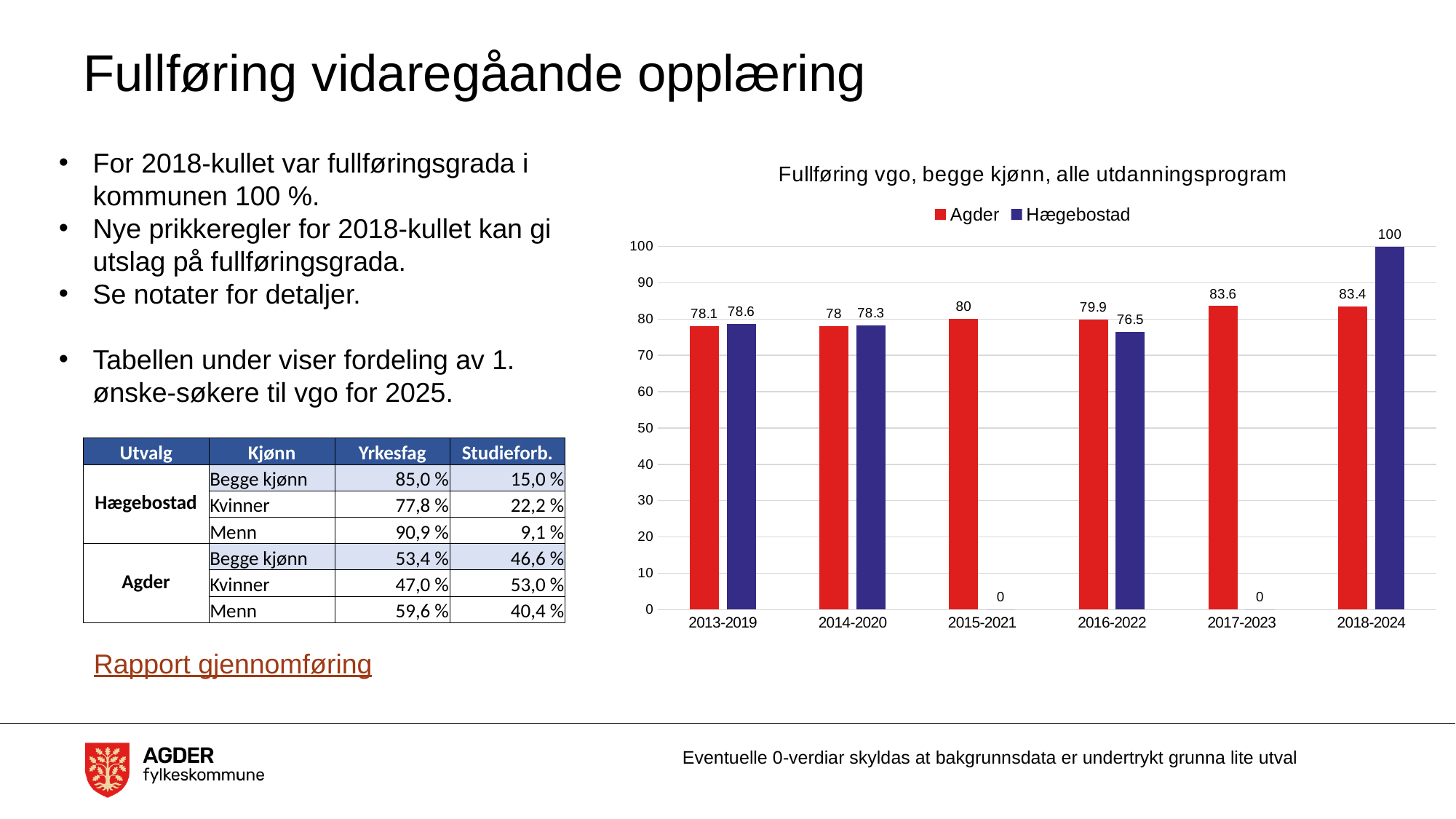
What is the difference between the Agder and Hægebostad values in 2016-2022? 3.4 In which period is the Agder value highest? 2017-2023 How many periods are shown on the x axis? 6 What kind of chart is shown? Bar chart What is the value for Hægebostad in 2016-2022? 76.5 Which is larger in 2014-2020, Agder or Hægebostad? Hægebostad What is the value for Agder in 2017-2023? 83.6 How many series does the legend list? 2 What is the title of the chart? Fullføring vgo, begge kjønn, alle utdanningsprogram What is the value for Hægebostad in 2018-2024? 100 What is the value for Agder in 2013-2019? 78.1 In which period is the Agder value lowest? 2014-2020